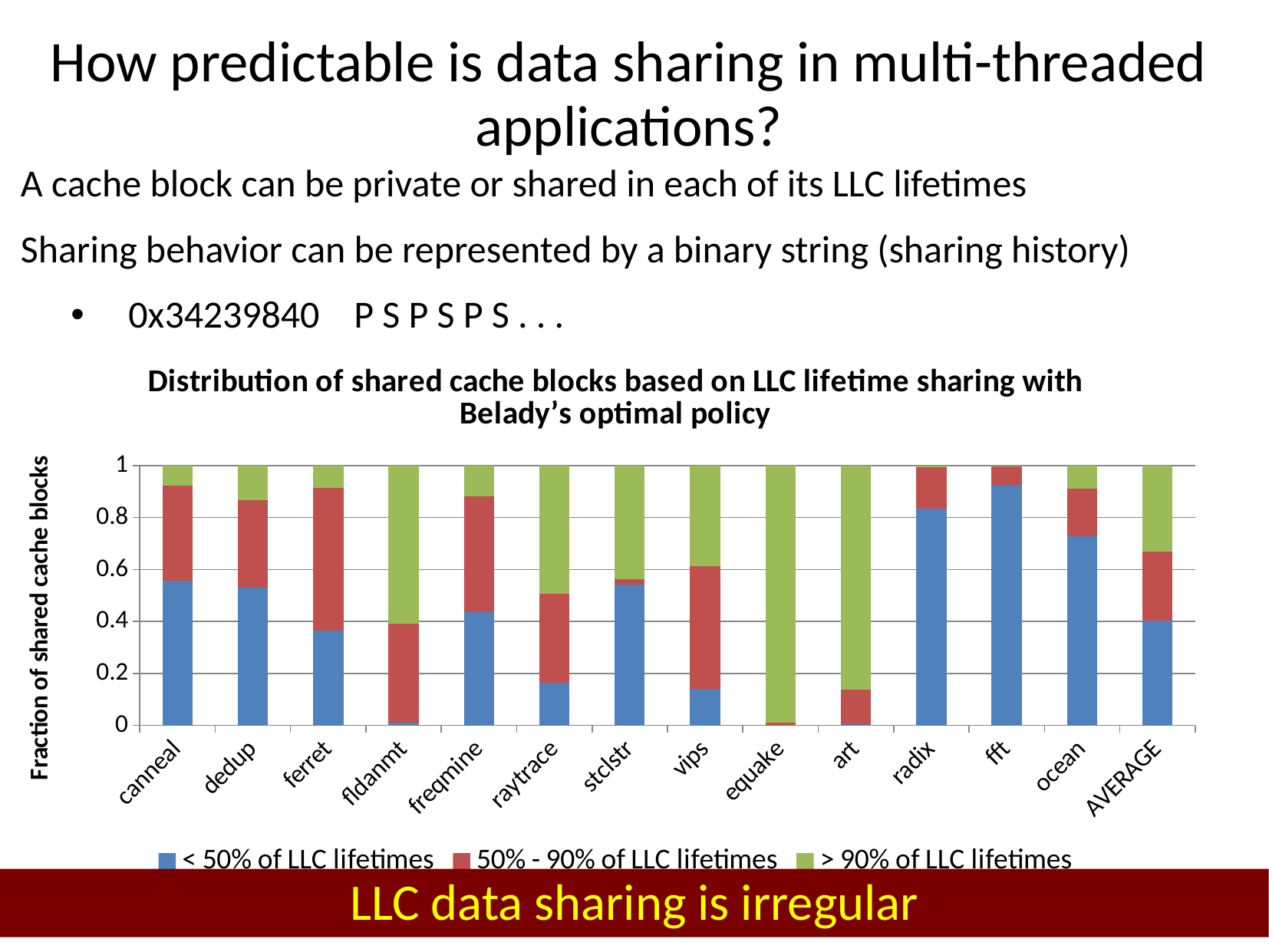
What is the total height of the stacked bar for canneal? 1 How many series does the chart's legend list? 3 Is the '< 50% of LLC lifetimes' value for vips greater or less than 0.2? less Is the '< 50% of LLC lifetimes' value for ocean greater or less than 0.6? greater What kind of chart is shown on the slide? Stacked bar chart How many categories (benchmarks) are shown along the x axis of the chart? 14 Which category has the largest '> 90% of LLC lifetimes' (green) segment? equake Which category has the largest '< 50% of LLC lifetimes' (blue) segment? fft Which category has the largest '50% - 90% of LLC lifetimes' (red) segment? ferret Is the '< 50% of LLC lifetimes' value for canneal greater or less than 0.4? greater What is the label of the y axis of the chart? Fraction of shared cache blocks Which has a larger '< 50% of LLC lifetimes' segment, canneal or ferret? canneal